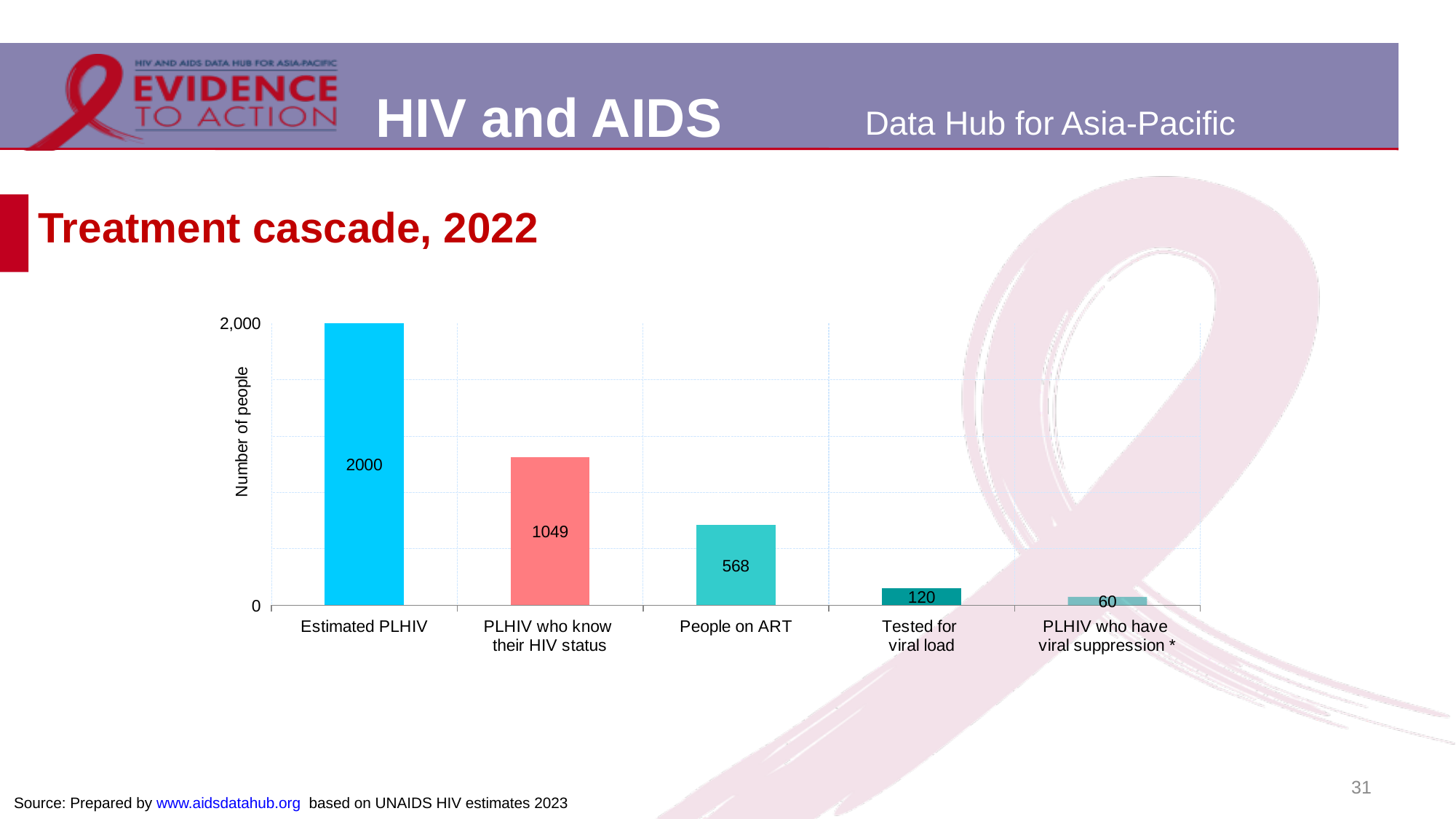
What is the difference between People on ART and Tested for viral load? 448 What is the difference between Estimated PLHIV and PLHIV who know their HIV status? 951 Which category has the lowest value? PLHIV who have viral suppression * How many categories are shown on the x axis? 5 Which is larger, the value for People on ART or the value for Tested for viral load? People on ART What is the value for PLHIV who have viral suppression *? 60 What is the value for PLHIV who know their HIV status? 1049 What is the value for Estimated PLHIV? 2000 Do the values rise or fall from left to right along the x axis? fall What is the value for Tested for viral load? 120 What is the value for People on ART? 568 Which category has the highest value? Estimated PLHIV